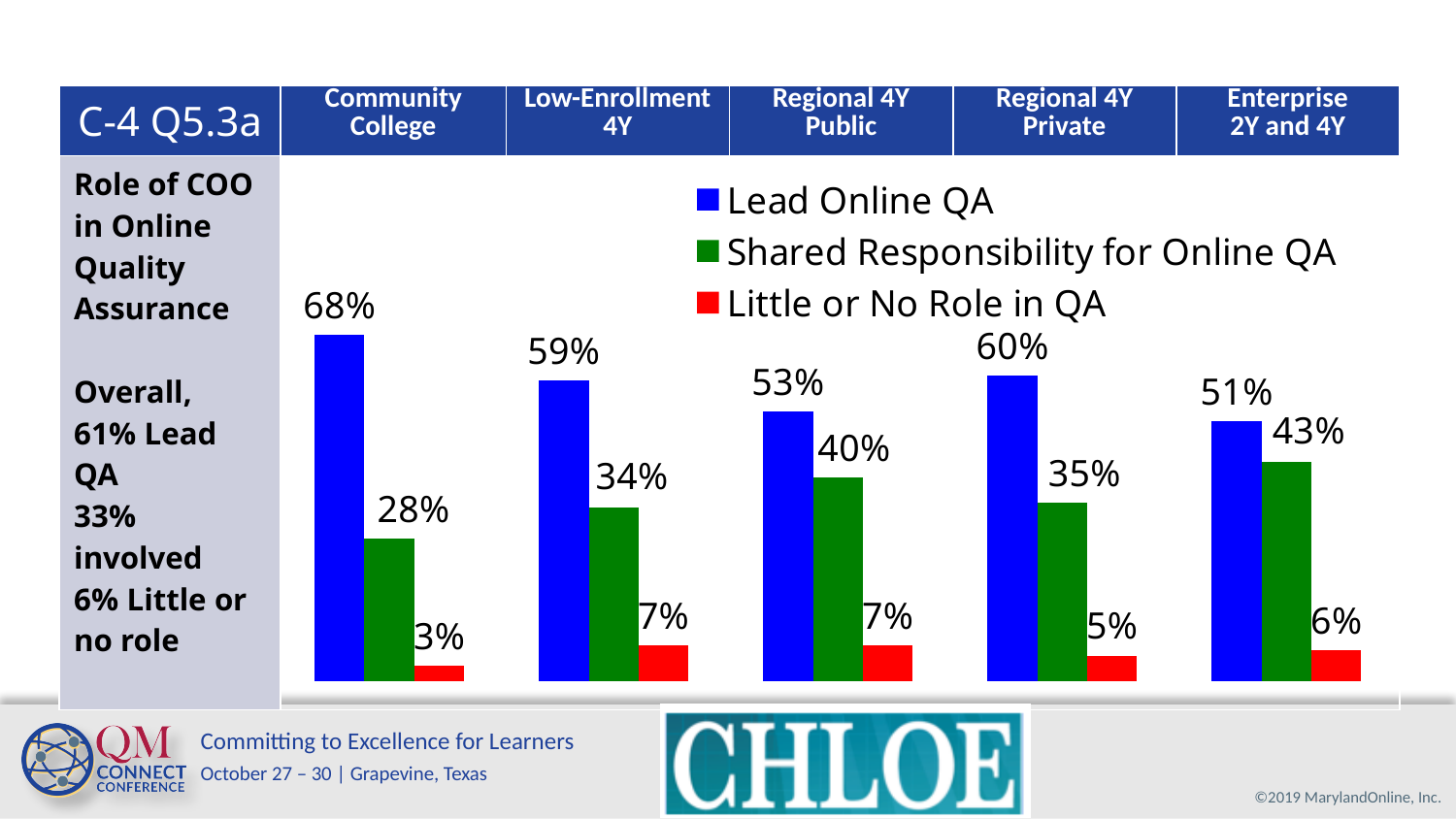
How many series does the legend list? 3 Which colour represents Little or No Role in QA in the chart? Red How many institution categories are shown in the chart? 5 What is the difference between the Lead Online QA values for Community College and Enterprise 2Y and 4Y? 17% Which institution category has the highest value for Lead Online QA? Community College What is the value for Little or No Role in QA in the Regional 4Y Private category? 5% Which institution category has the lowest value for Little or No Role in QA? Community College What percentage of Community College respondents report the COO leads Online QA? 68% What type of chart is shown on the slide? Bar chart What is the total of the three values for the Low-Enrollment 4Y category? 100% Which is larger: Shared Responsibility for Online QA in Enterprise 2Y and 4Y or in Low-Enrollment 4Y? Enterprise 2Y and 4Y What is the value for Shared Responsibility for Online QA in the Regional 4Y Public category? 40%